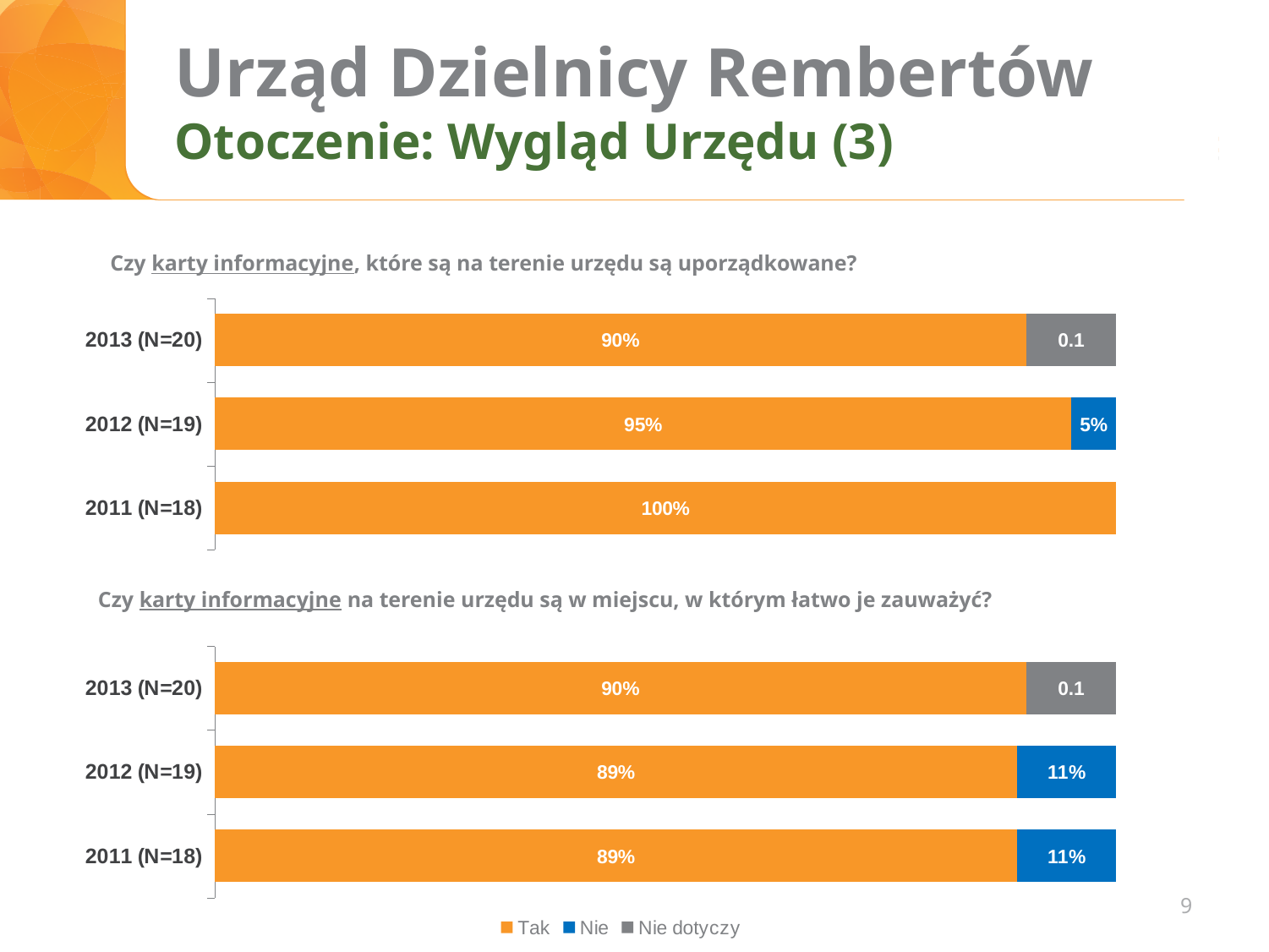
In the top chart, what is the difference between the "Tak" values for 2011 (N=18) and 2013 (N=20)? 10% In the top chart, what is the "Tak" value for 2011 (N=18)? 100% In the top chart, which year has the highest "Tak" value? 2011 (N=18) In the bottom chart, what label is shown on the grey "Nie dotyczy" segment for 2013 (N=20)? 0.1 In the bottom chart, is the "Tak" value for 2013 (N=20) larger or smaller than the "Tak" value for 2012 (N=19)? larger In the top chart ("Czy karty informacyjne, które są na terenie urzędu są uporządkowane?"), what is the "Tak" value for 2013 (N=20)? 90% How many series does the legend at the bottom of the slide list? 3 In the bottom chart, what is the "Tak" value for 2011 (N=18)? 89% In the top chart, which year has the lowest "Tak" value? 2013 (N=20) In the bottom chart ("Czy karty informacyjne na terenie urzędu są w miejscu, w którym łatwo je zauważyć?"), what is the "Nie" value for 2012 (N=19)? 11% What type of chart is the top chart? stacked bar chart In the top chart, what is the "Nie" value for 2012 (N=19)? 5%